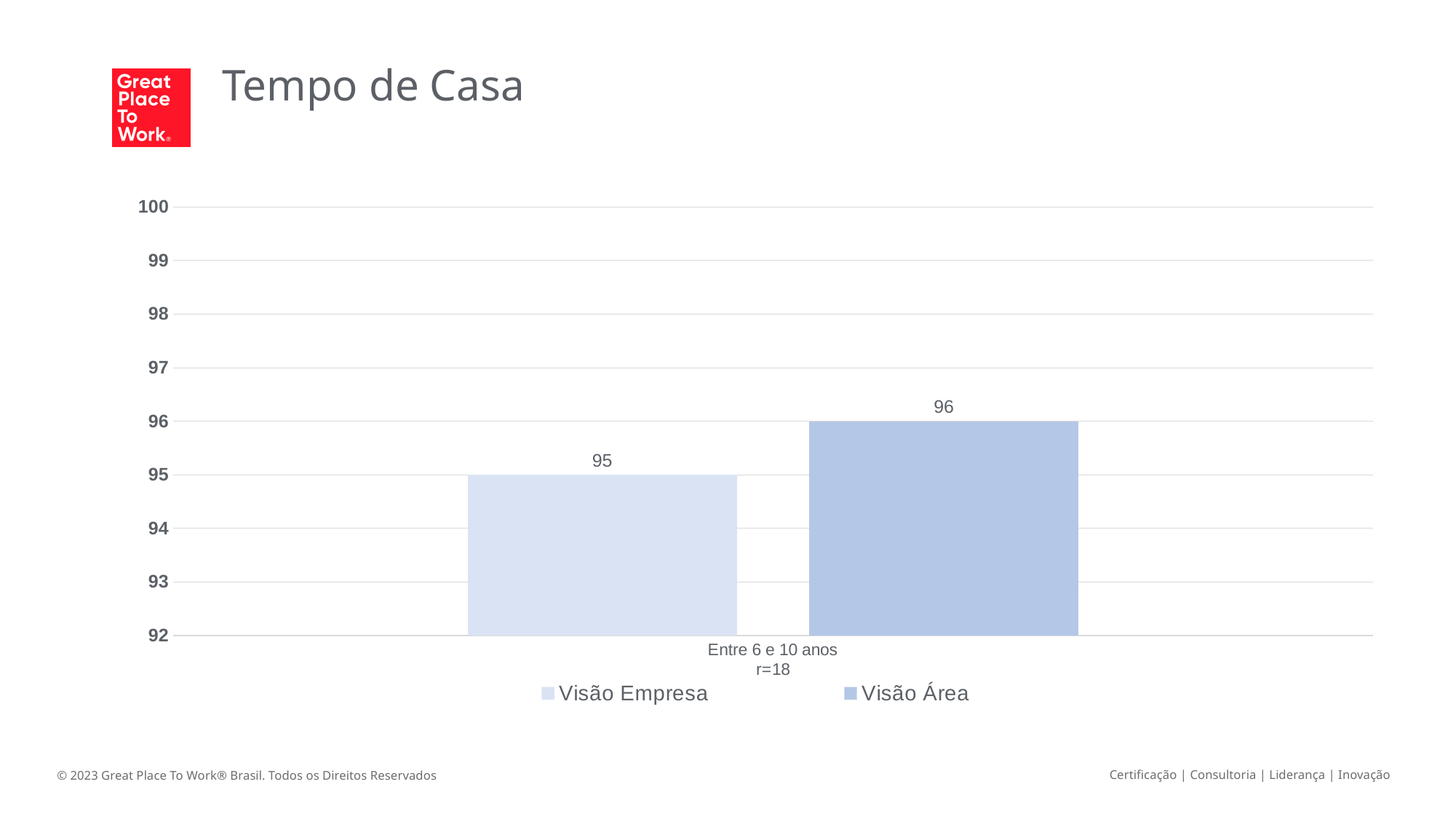
What is the respondent count (r) shown for the 'Entre 6 e 10 anos' category? r=18 How many categories are shown on the x axis? 1 What is the difference between the Visão Área and Visão Empresa values for 'Entre 6 e 10 anos'? 1 Is the value for Visão Área greater or less than 98? less What is the lowest value shown on the y axis? 92 What kind of chart is shown on the slide? Bar chart Which series has the higher value for 'Entre 6 e 10 anos': Visão Empresa or Visão Área? Visão Área Is the value for Visão Empresa greater or less than 94? greater What is the title of the slide? Tempo de Casa What is the value for Visão Área in the 'Entre 6 e 10 anos' category? 96 What is the value for Visão Empresa in the 'Entre 6 e 10 anos' category? 95 How many series does the legend list? 2